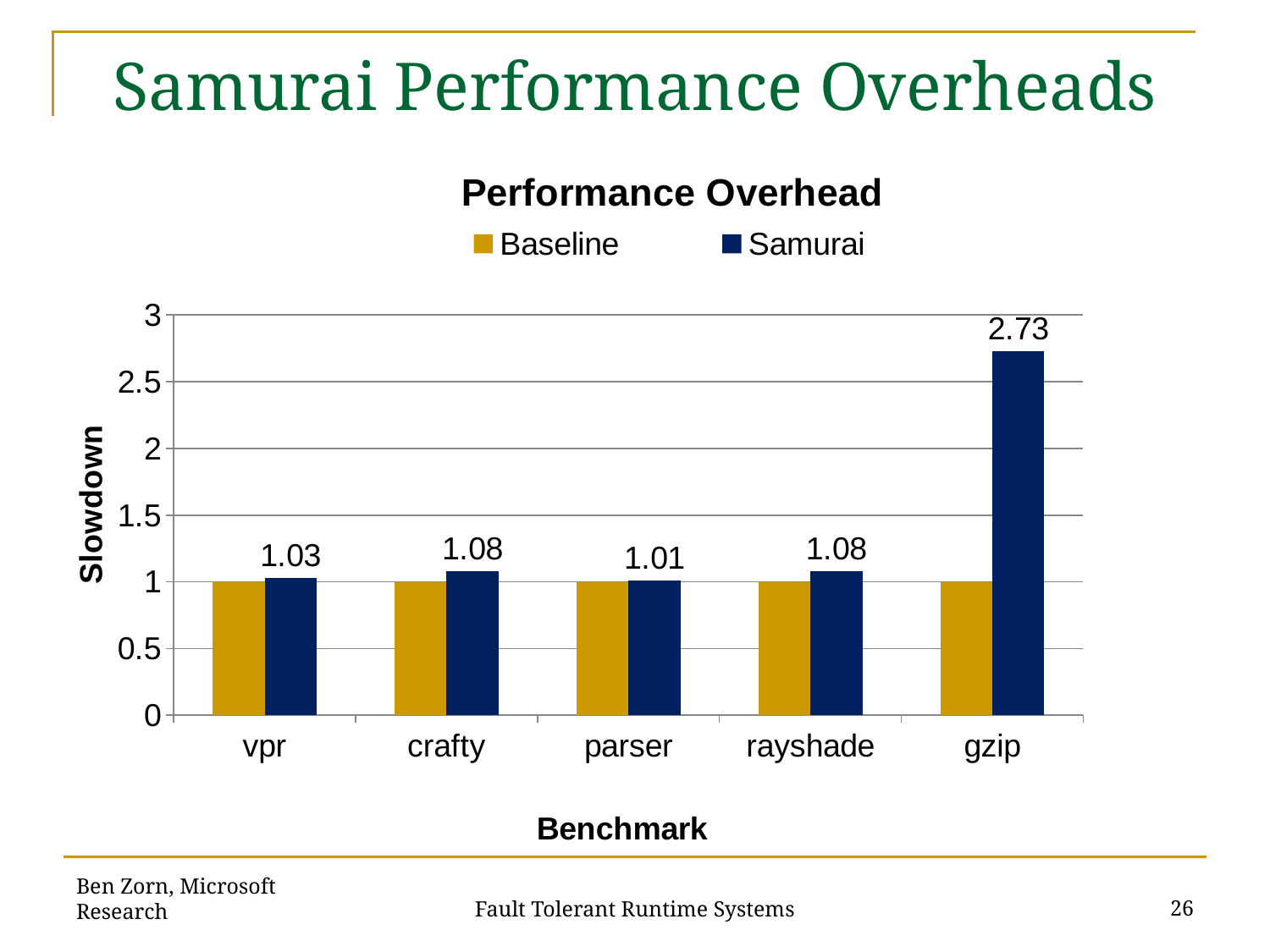
What is the Samurai slowdown for parser? 1.01 Which benchmark has the highest Samurai slowdown? gzip What type of chart is shown on the slide? bar chart How many benchmarks are shown on the x axis? 5 What is the Samurai slowdown for crafty? 1.08 Which is larger, the Samurai slowdown for crafty or for parser? crafty How many series does the legend list? 2 Is the Samurai value for gzip greater or less than 2.5? greater Which benchmark has the lowest Samurai slowdown? parser What is the difference between the Samurai slowdown for gzip and for vpr? 1.7 What is the Samurai slowdown for gzip? 2.73 What is the Samurai slowdown for vpr? 1.03